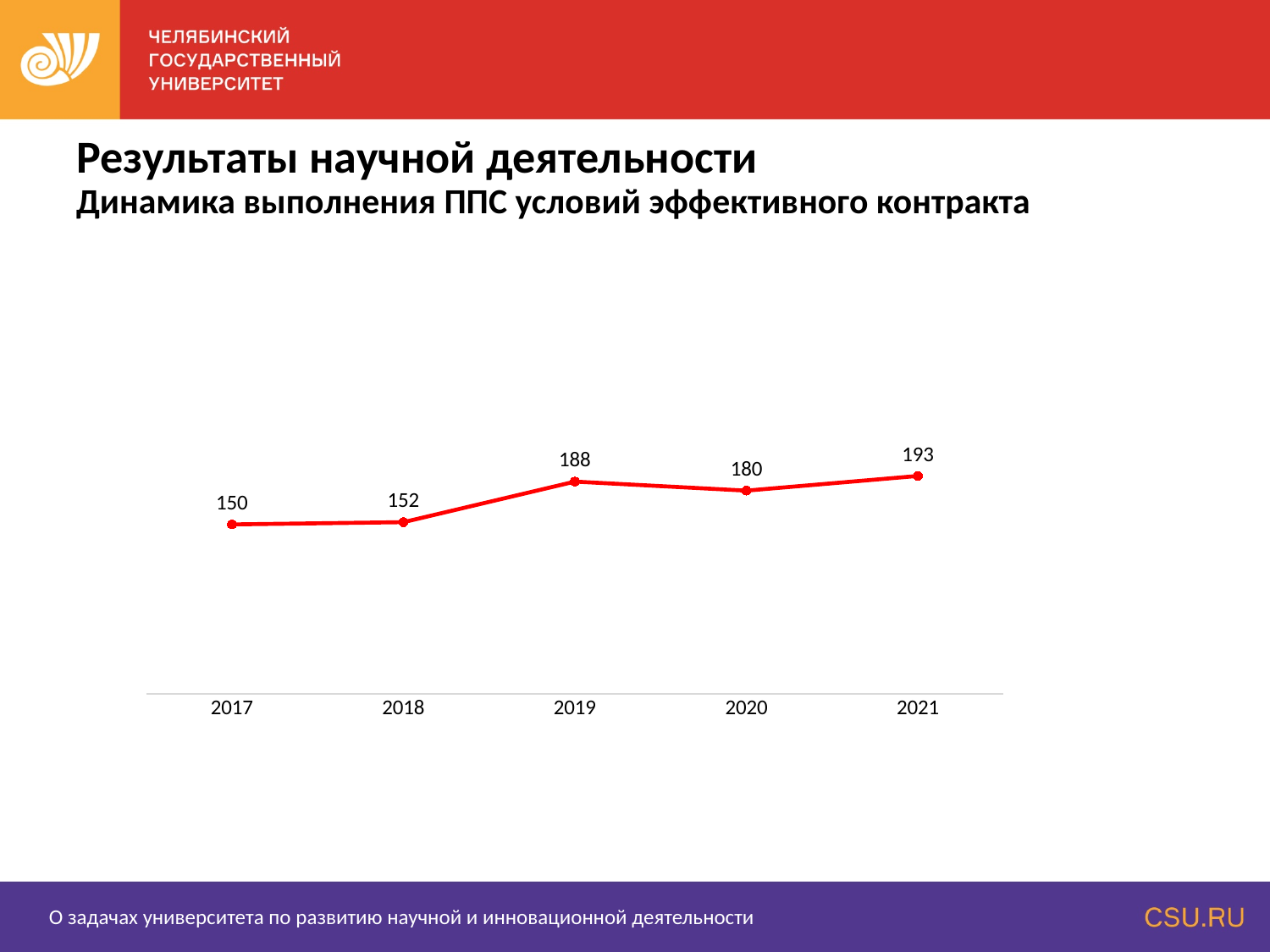
Do the values generally rise or fall from 2017 to 2021? rise Which is larger, the value for 2019 or the value for 2020? 2019 Which year has the highest value? 2021 What is the value for 2020? 180 Which year has the lowest value? 2017 What is the value for 2019? 188 What is the value for 2017? 150 What kind of chart is shown on the slide? line chart What is the difference between the values for 2021 and 2017? 43 How many years are plotted on the chart? 5 What is the value for 2021? 193 What is the difference between the values for 2019 and 2020? 8